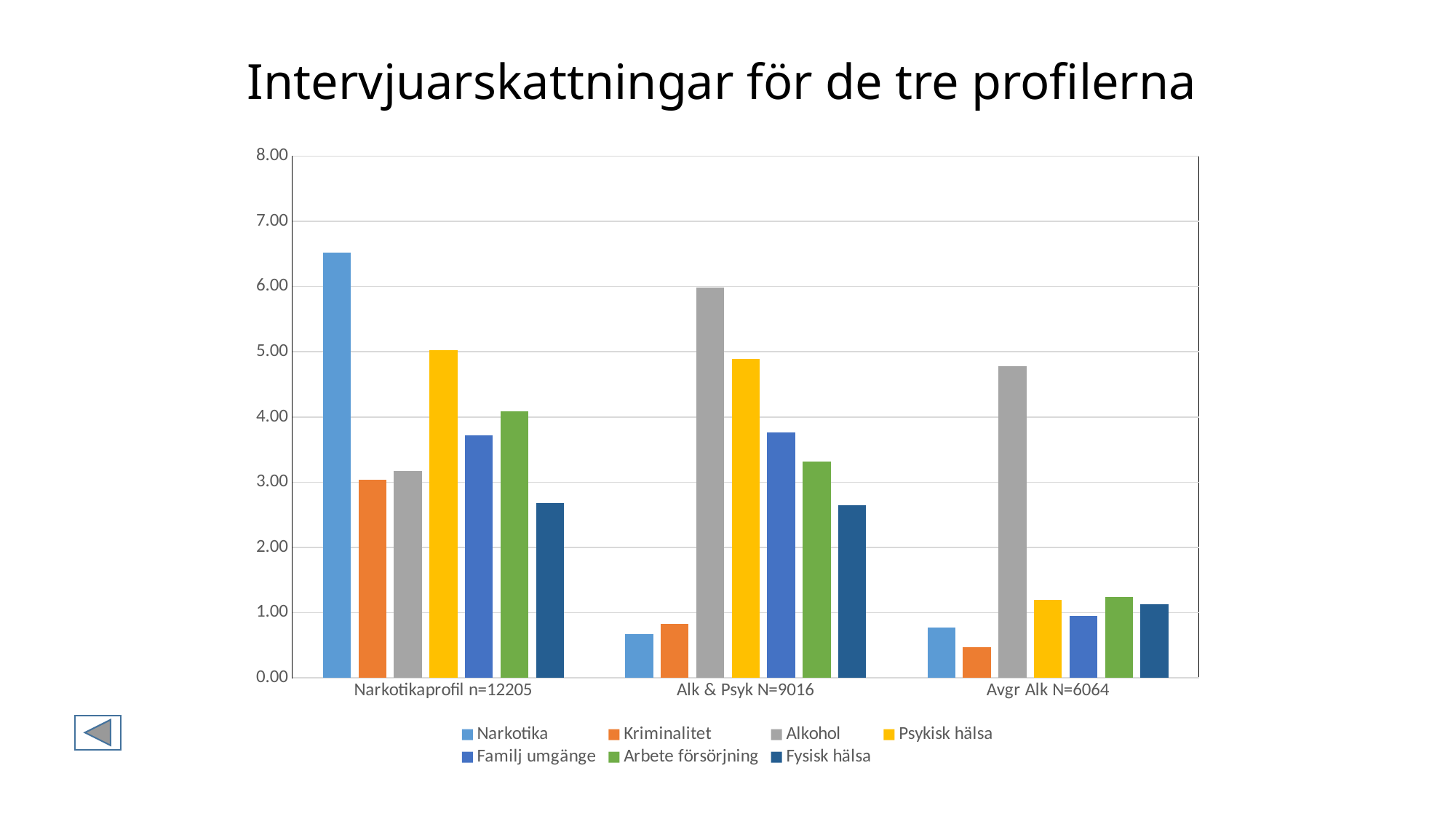
How many series does the legend list? 7 Is the value for Alkohol in Avgr Alk N=6064 greater or less than 5.00? less Which is larger: the Alkohol value for Alk & Psyk N=9016 or for Avgr Alk N=6064? Alk & Psyk N=9016 Which series has the highest value for Alk & Psyk N=9016? Alkohol How many profile categories are shown on the x axis? 3 Is the value for Fysisk hälsa in Alk & Psyk N=9016 greater or less than 3.00? less Which series has the highest value for Narkotikaprofil n=12205? Narkotika Which series has the lowest value for Narkotikaprofil n=12205? Fysisk hälsa Which series has the lowest value for Avgr Alk N=6064? Kriminalitet Does the Kriminalitet value rise or fall across the three profiles from left to right? fall What kind of chart is shown on the slide? bar chart Is the value for Narkotika in Narkotikaprofil n=12205 greater or less than 6.00? greater